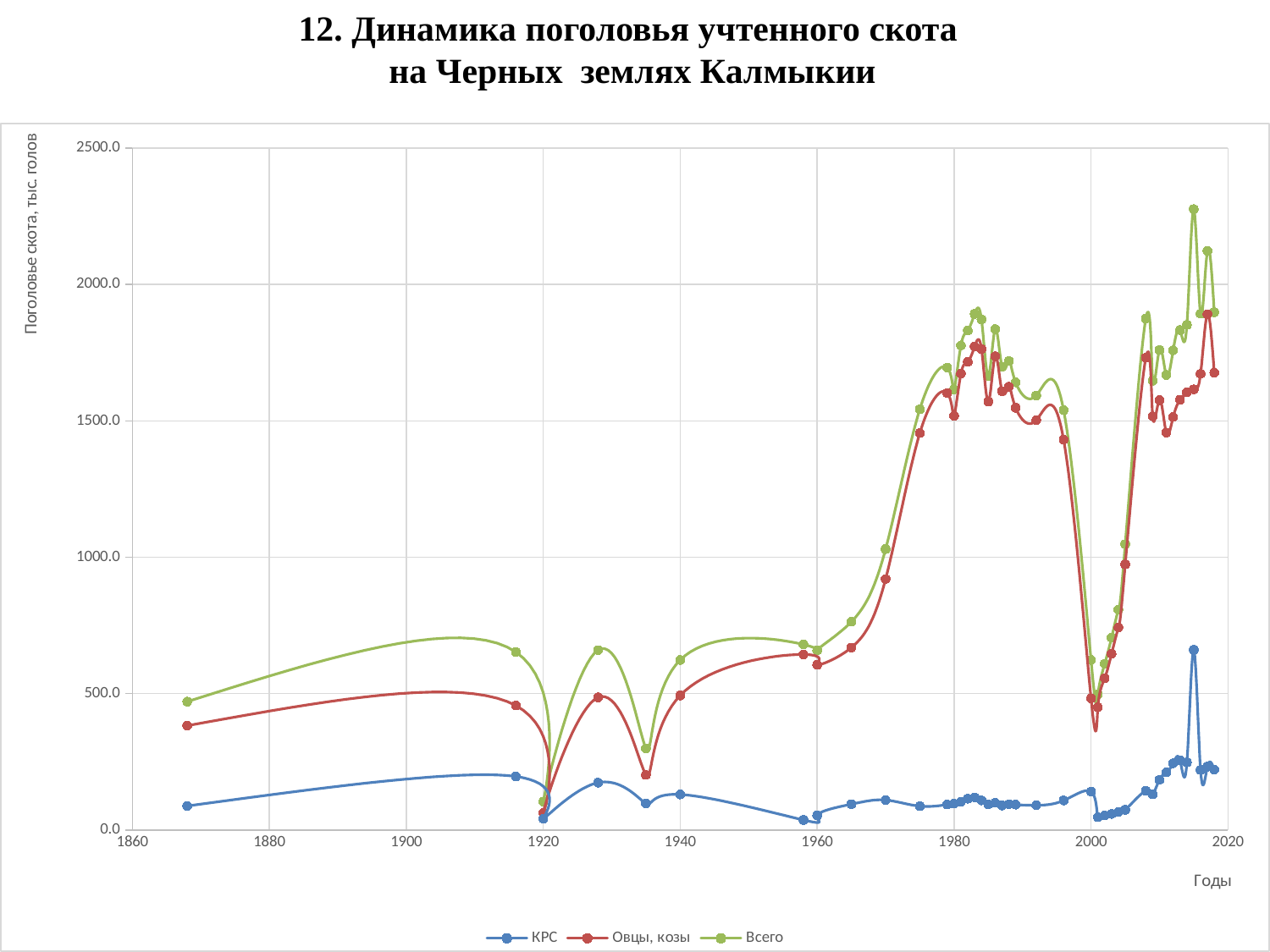
Is the peak value of the Всего series around 2015 greater or less than 2000? greater Which is larger in 1980: the value for Всего or the value for КРС? Всего What kind of chart is shown on the slide? line chart Is the value of КРС in 1868 greater or less than 500? less Which series are listed in the legend? КРС, Овцы, козы, Всего Is the value of Всего in 1920 greater or less than 500? less Which series has the highest values across the chart? Всего Does the Овцы, козы series rise or fall between 1960 and 1980? rise How many series does the legend list? 3 Which series has the lowest values across the chart? КРС What is the label of the vertical axis? Поголовье скота, тыс. голов